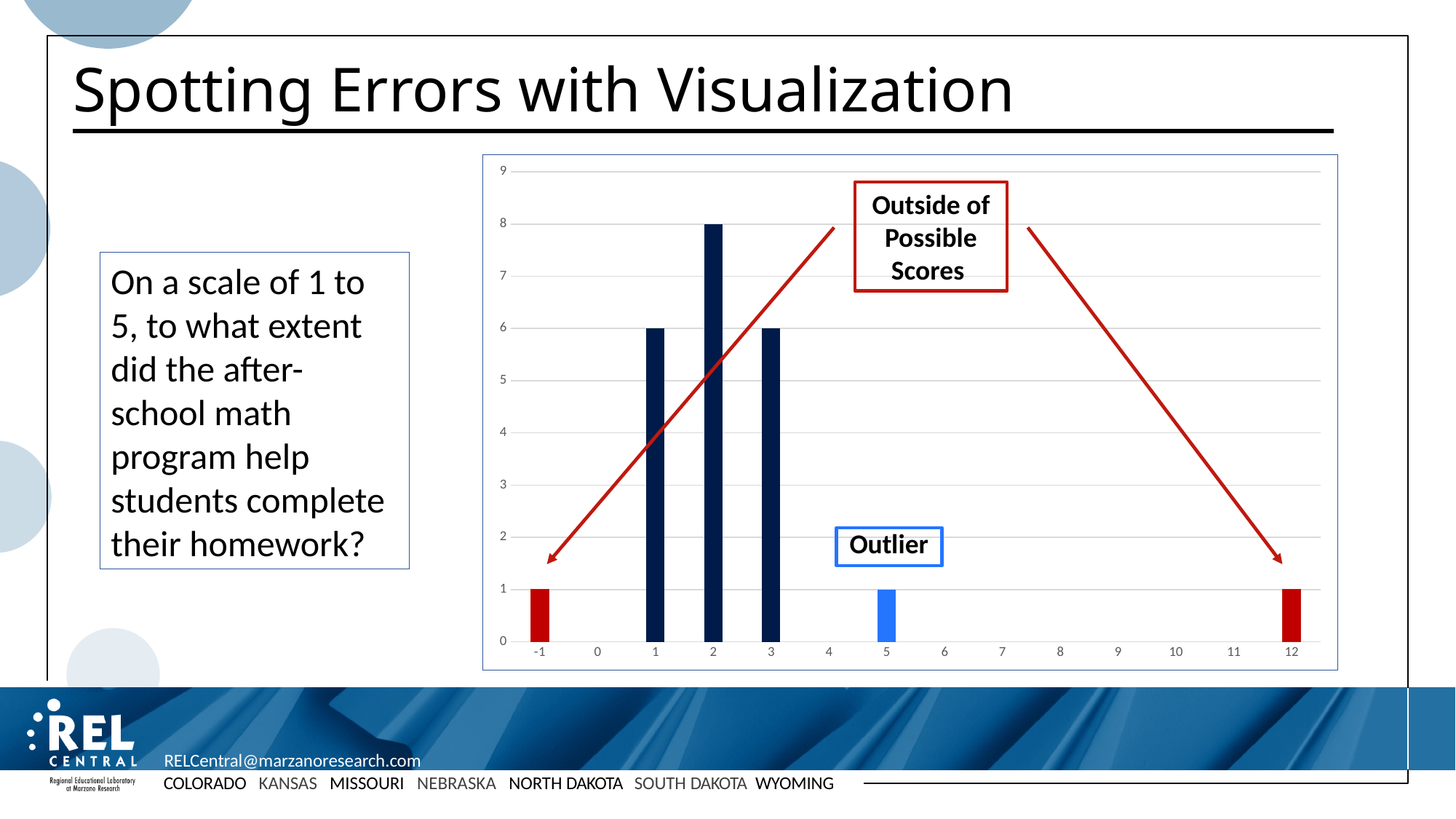
What label is shown in the blue box pointing to the bar at category 5? Outlier What is the value of the bar at category 2? 8 What is the value of the bar at category 12? 1 What kind of chart is shown on the slide? bar chart What is the difference between the bar at category 2 and the bar at category 1? 2 How many categories are labelled on the x axis? 14 What is the value of the bar at category 3? 6 Which category has the highest bar? 2 Which is larger, the bar at category 2 or the bar at category 3? 2 What is the value of the bar at category 5? 1 What is the value of the bar at category 1? 6 Is the value for category 2 greater or less than 7? greater